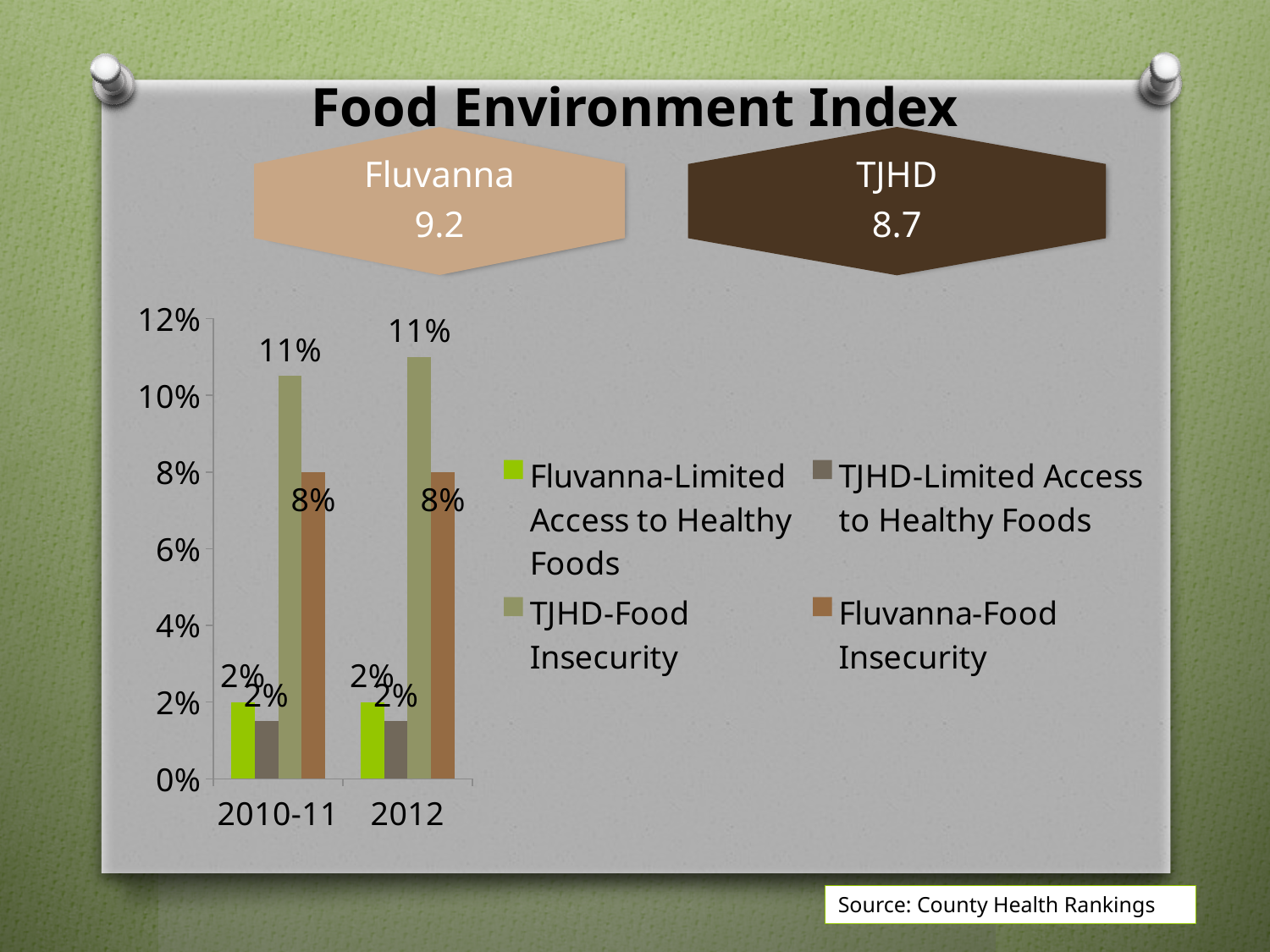
What is the value for Fluvanna-Limited Access to Healthy Foods in 2012? 2% What type of chart is shown on the slide? bar chart What is the difference between TJHD-Food Insecurity and Fluvanna-Food Insecurity in 2010-11? 3% Which series has the highest value in 2012? TJHD-Food Insecurity Is the value for TJHD-Food Insecurity in 2010-11 greater or less than 10%? greater What is the title of the slide containing the chart? Food Environment Index Which is larger in 2012, TJHD-Food Insecurity or Fluvanna-Food Insecurity? TJHD-Food Insecurity Does the value for Fluvanna-Food Insecurity rise, fall, or stay the same from 2010-11 to 2012? stays the same How many series does the chart legend list? 4 What is the value for Fluvanna-Food Insecurity in 2012? 8% How many categories are shown on the x axis of the chart? 2 What is the value for TJHD-Food Insecurity in 2010-11? 11%